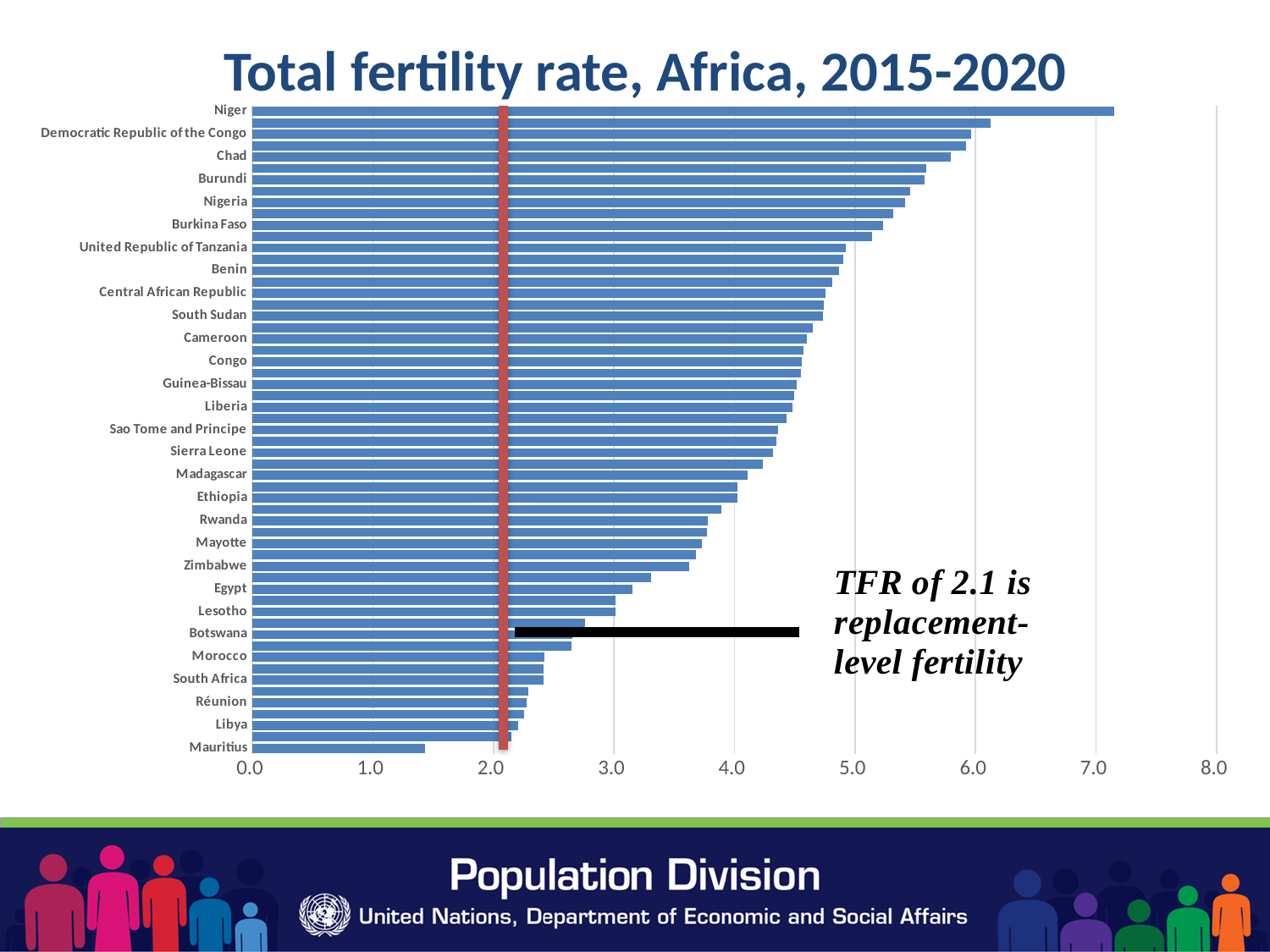
Do the bar values rise or fall going from the top of the chart (Niger) to the bottom (Mauritius)? fall Is the value for Niger greater or less than 6.0? greater Which has a higher total fertility rate, Chad or Nigeria? Chad Is the value for Chad greater or less than 5.0? greater What is the title of the chart? Total fertility rate, Africa, 2015-2020 Which country has the highest total fertility rate in the chart? Niger Is the value for Zimbabwe greater or less than 4.0? less What kind of chart is shown on the slide? Bar chart What TFR value does the red vertical line mark, according to the annotation? 2.1 Which country has the lowest total fertility rate in the chart? Mauritius